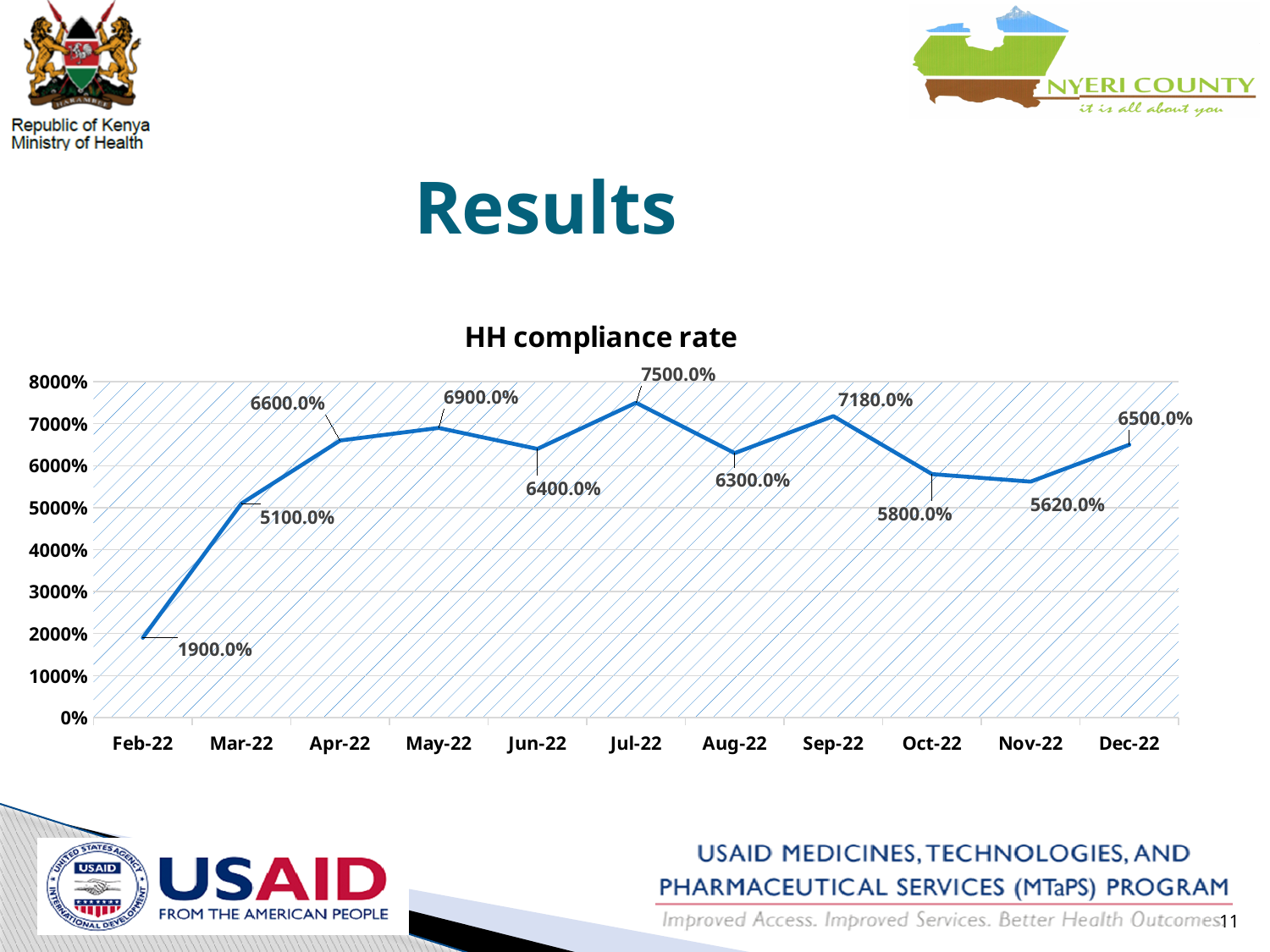
Does the HH compliance rate rise or fall from Feb-22 to Apr-22? Rise What kind of chart is used to show the HH compliance rate? Line chart What is the HH compliance rate for Feb-22? 1900.0% Which month has the highest HH compliance rate? Jul-22 Which month has a higher HH compliance rate, Apr-22 or Dec-22? Apr-22 Which month has the lowest HH compliance rate? Feb-22 What is the HH compliance rate for Jul-22? 7500.0% What is the HH compliance rate for Nov-22? 5620.0% Is the HH compliance rate for Oct-22 greater or less than 6000%? less How many months are plotted on the HH compliance rate chart? 11 What is the difference between the HH compliance rate in Jul-22 and in Aug-22? 1200.0% What is the HH compliance rate for Sep-22? 7180.0%